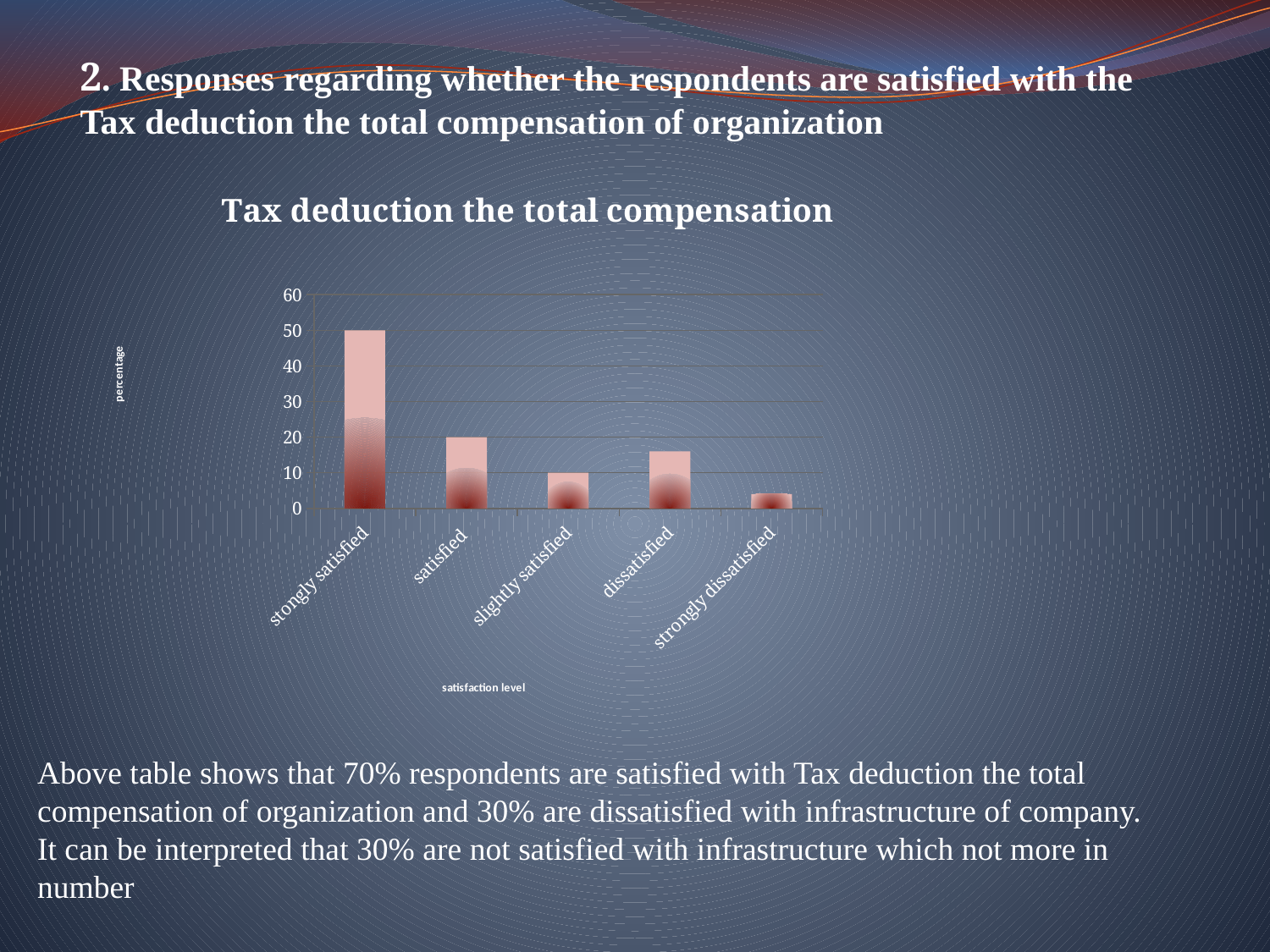
Is the value for 'dissatisfied' greater or less than 10? greater What is the difference between the percentages for 'stongly satisfied' and 'satisfied'? 30 Which satisfaction level has the lowest percentage in the chart? strongly dissatisfied What type of chart is shown on the slide? bar chart What percentage is shown for 'slightly satisfied'? 10 What is the title of the chart? Tax deduction the total compensation What percentage is shown for 'satisfied'? 20 Is the value for 'strongly dissatisfied' greater or less than 10? less What percentage is shown for 'stongly satisfied'? 50 How many satisfaction-level categories are plotted in the chart? 5 Which satisfaction level has the highest percentage in the chart? stongly satisfied Which is larger, the value for 'satisfied' or the value for 'slightly satisfied'? satisfied